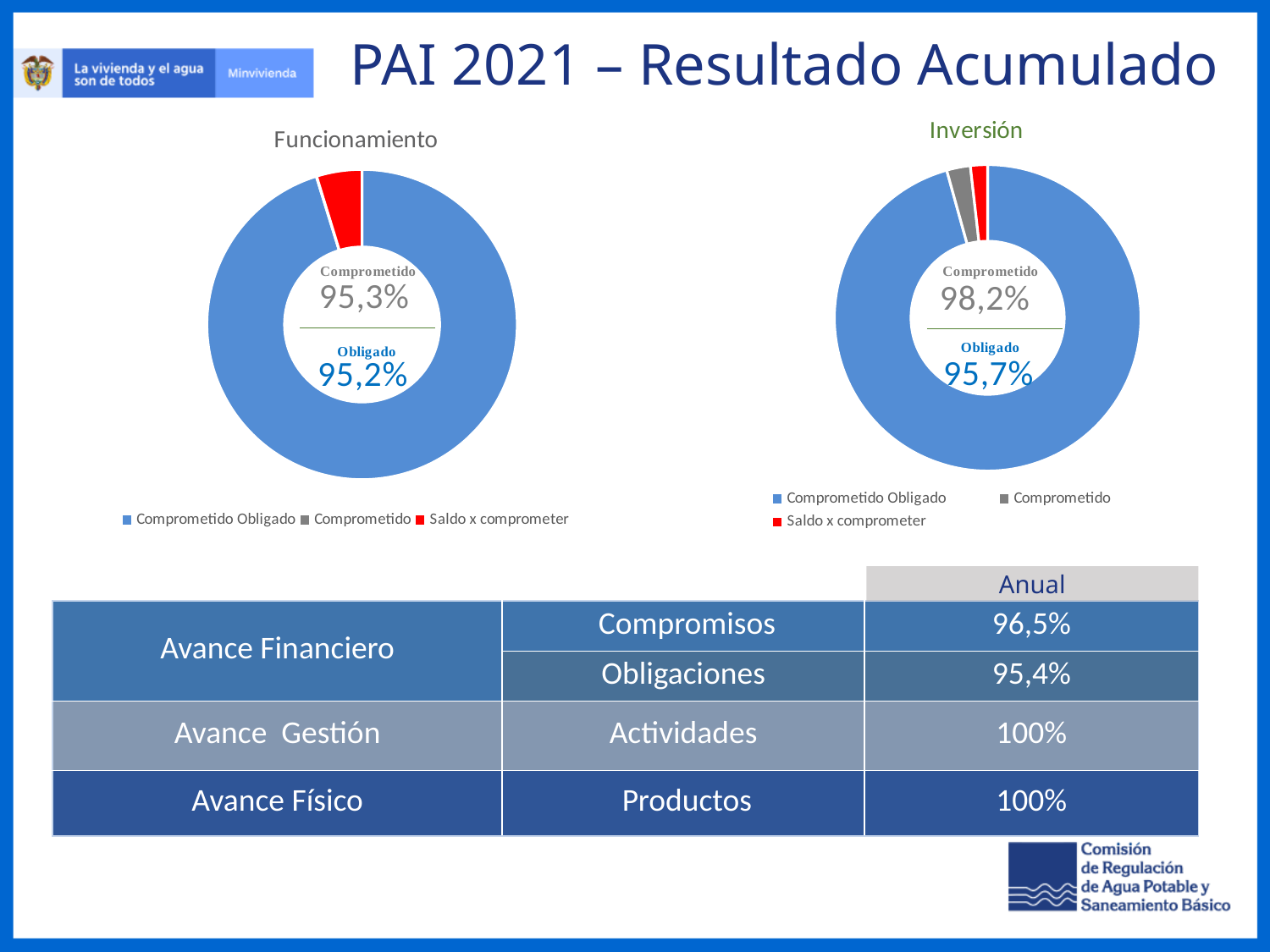
Which chart shows a higher Comprometido percentage in its centre, Funcionamiento or Inversión? Inversión What is the difference between the Obligado percentage shown for Inversión and the one shown for Funcionamiento? 0,5 percentage points In the Funcionamiento chart, which category takes up the largest share of the ring? Comprometido Obligado In the Funcionamiento chart, what percentage is shown for Comprometido in the centre? 95,3% In the Inversión chart, what percentage is shown for Obligado in the centre? 95,7% What type of chart is used for Funcionamiento and Inversión? Pie (donut) chart In the Funcionamiento chart, what percentage is shown for Obligado in the centre? 95,2% In the Inversión chart, what percentage is shown for Comprometido in the centre? 98,2% In the legend of the Funcionamiento chart, which colour represents Saldo x comprometer? Red What is the difference between the Comprometido percentage shown for Inversión and the one shown for Funcionamiento? 2,9 percentage points How many entries does the legend of the Funcionamiento chart list? 3 In the Inversión chart, which category takes up the largest share of the ring? Comprometido Obligado